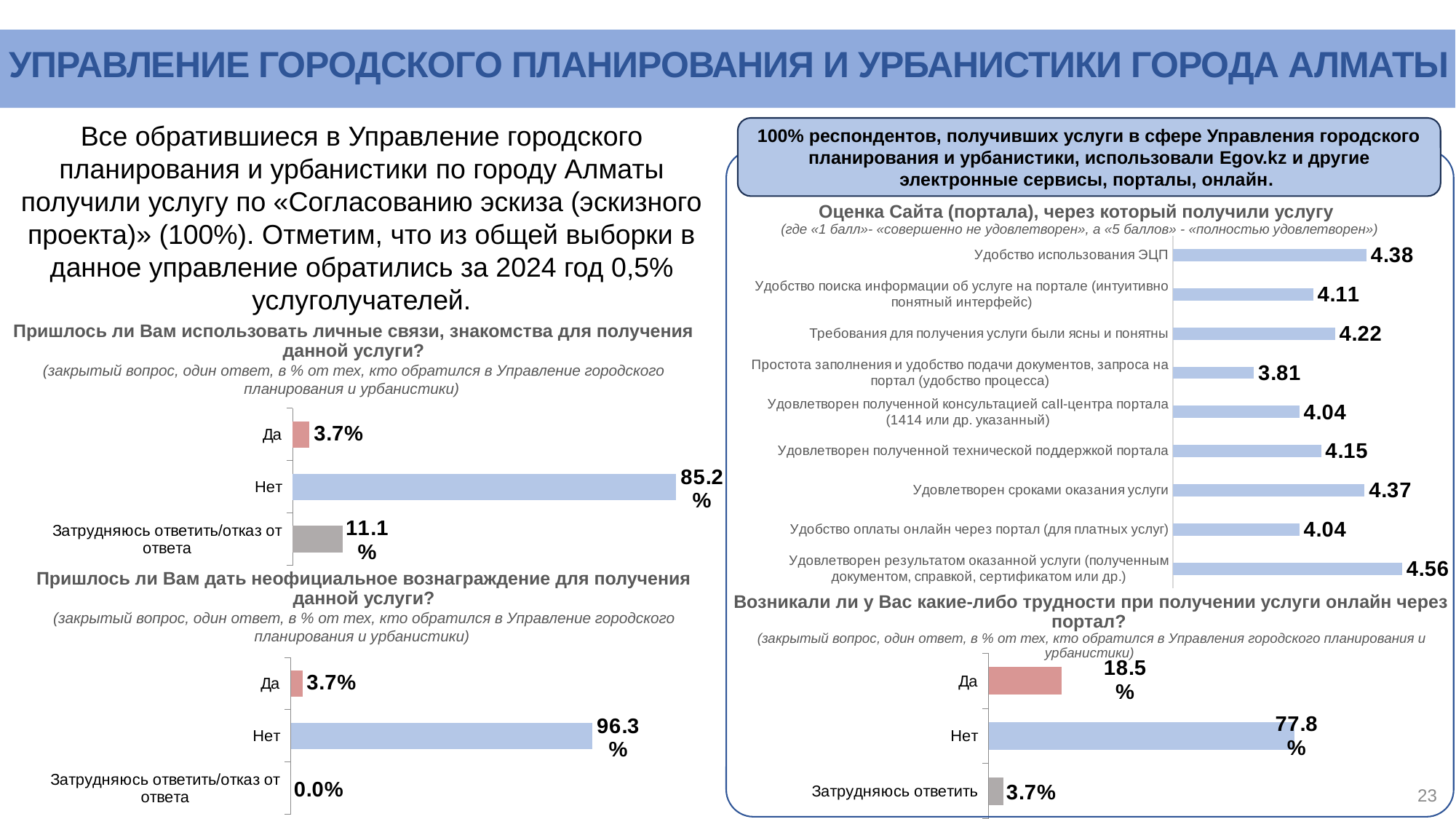
In the chart 'Пришлось ли Вам использовать личные связи, знакомства для получения данной услуги?', what is the value for 'Нет'? 85.2% In the chart 'Возникали ли у Вас какие-либо трудности при получении услуги онлайн через портал?', what is the value for 'Да'? 18.5% In the chart 'Оценка Сайта (портала), через который получили услугу', what is the difference between 'Удовлетворен сроками оказания услуги' and 'Удобство оплаты онлайн через портал (для платных услуг)'? 0.33 In the chart 'Пришлось ли Вам использовать личные связи, знакомства для получения данной услуги?', what is the value for 'Затрудняюсь ответить/отказ от ответа'? 11.1% In the chart 'Пришлось ли Вам дать неофициальное вознаграждение для получения данной услуги?', what is the difference between 'Нет' and 'Да'? 92.6% In the chart 'Оценка Сайта (портала), через который получили услугу', how many categories are plotted? 9 In the chart 'Оценка Сайта (портала), через который получили услугу', what is the value for 'Удобство использования ЭЦП'? 4.38 In the chart 'Оценка Сайта (портала), через который получили услугу', which category has the highest value? Удовлетворен результатом оказанной услуги (полученным документом, справкой, сертификатом или др.) What type of chart is 'Оценка Сайта (портала), через который получили услугу'? Bar chart In the chart 'Оценка Сайта (портала), через который получили услугу', which category has the lowest value? Простота заполнения и удобство подачи документов, запроса на портал (удобство процесса) In the chart 'Пришлось ли Вам дать неофициальное вознаграждение для получения данной услуги?', what is the value for 'Нет'? 96.3% In the chart 'Возникали ли у Вас какие-либо трудности при получении услуги онлайн через портал?', which is larger, 'Да' or 'Затрудняюсь ответить'? Да